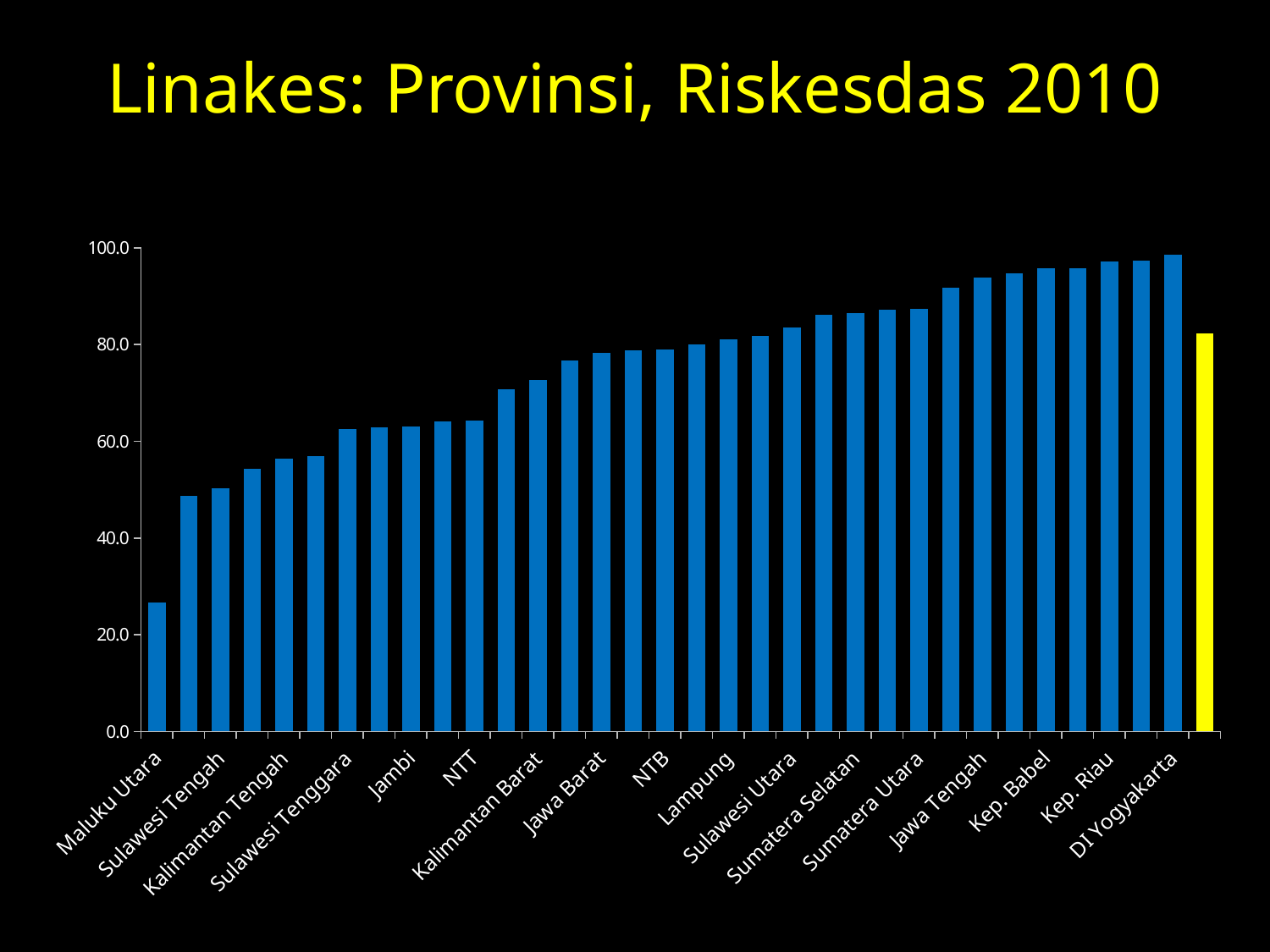
Is the value for DI Yogyakarta greater or less than 80.0? greater Is the value for Kalimantan Barat greater or less than 60.0? greater Do the blue bars rise or fall from left to right along the x axis? rise Which labelled province has the highest value? DI Yogyakarta Is the value for Maluku Utara greater or less than 40.0? less What kind of chart is shown on the slide? bar chart What is the title of the chart? Linakes: Provinsi, Riskesdas 2010 What colour is the rightmost bar, which differs from the others? yellow Which labelled province has the lowest value? Maluku Utara Which has the larger value, Jambi or Jawa Tengah? Jawa Tengah